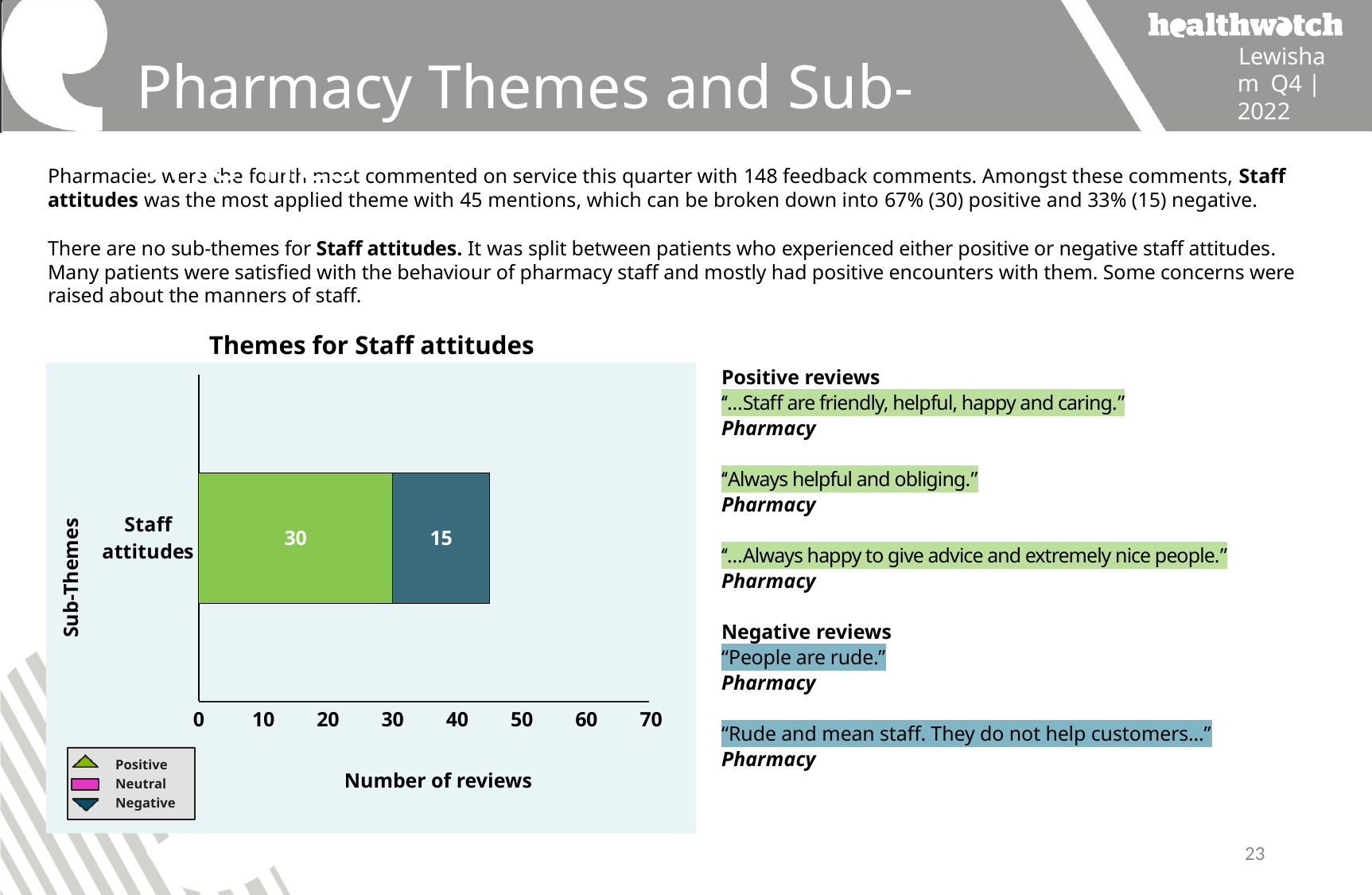
What type of chart is shown? bar chart What is the total of the stacked bar for Staff attitudes? 45 Is the total value for Staff attitudes greater or less than 40? greater Which series has the lowest value for Staff attitudes among those plotted with a visible segment? Negative How many categories are shown on the y axis? 1 What is the title of the chart? Themes for Staff attitudes What is the difference between the Positive and Negative values for Staff attitudes? 15 What is the label of the x axis? Number of reviews What is the Negative value for Staff attitudes? 15 How many series does the legend list? 3 What is the Positive value for Staff attitudes? 30 Which is larger for Staff attitudes, the Positive or the Negative value? Positive